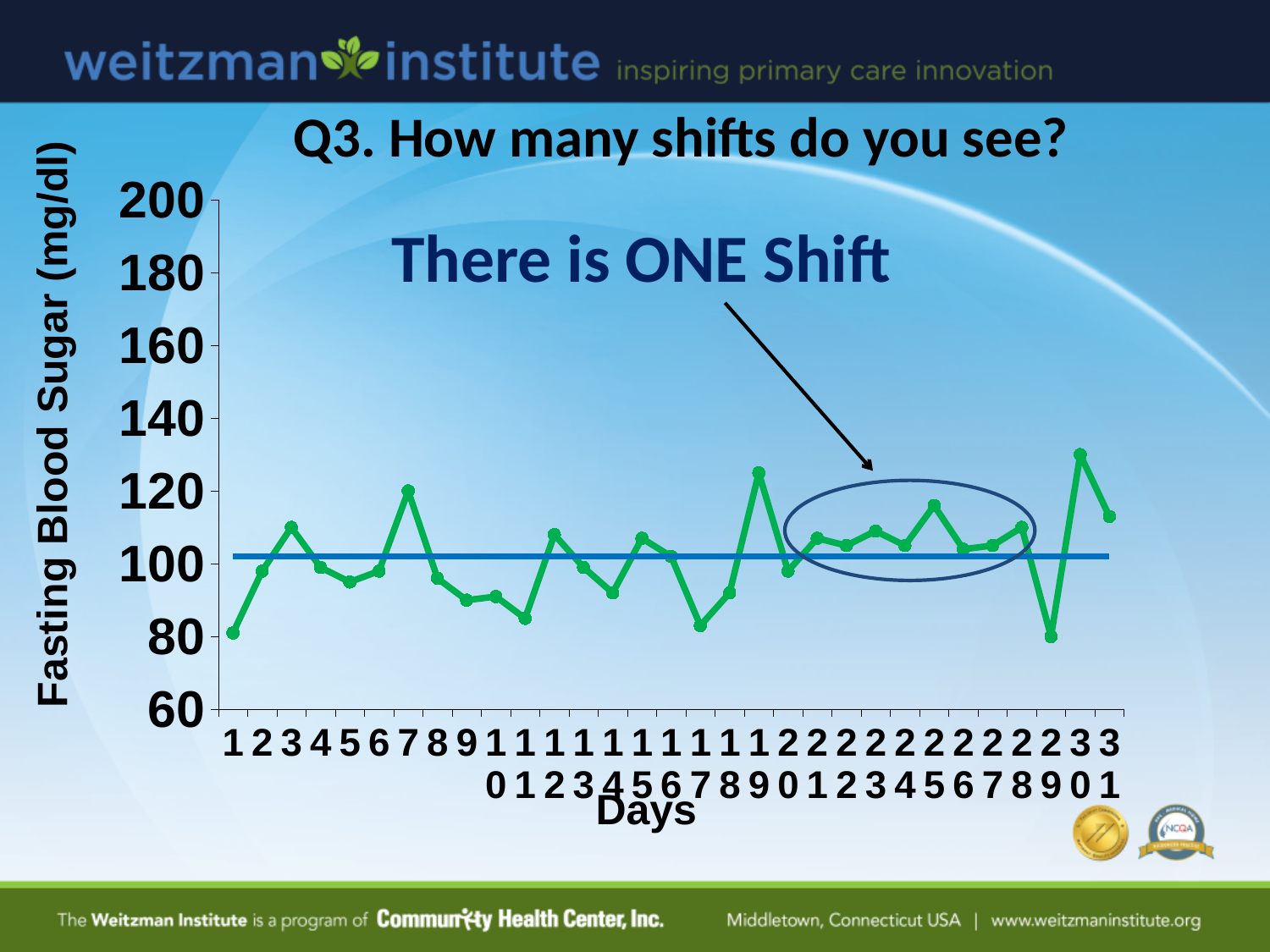
Is the value for day 30 greater or less than 120? greater Which is larger, the value for day 19 or the value for day 20? Day 19 Is the value for day 1 greater or less than 100? less How many days (data points) are plotted on the chart? 31 What is the title of the chart's vertical axis? Fasting Blood Sugar (mg/dl) What kind of chart is shown on the slide? line chart What is the title of the chart's horizontal axis? Days Is the value for day 7 greater or less than 100? greater Which day has the highest fasting blood sugar value? Day 30 Which is larger, the value for day 7 or the value for day 8? Day 7